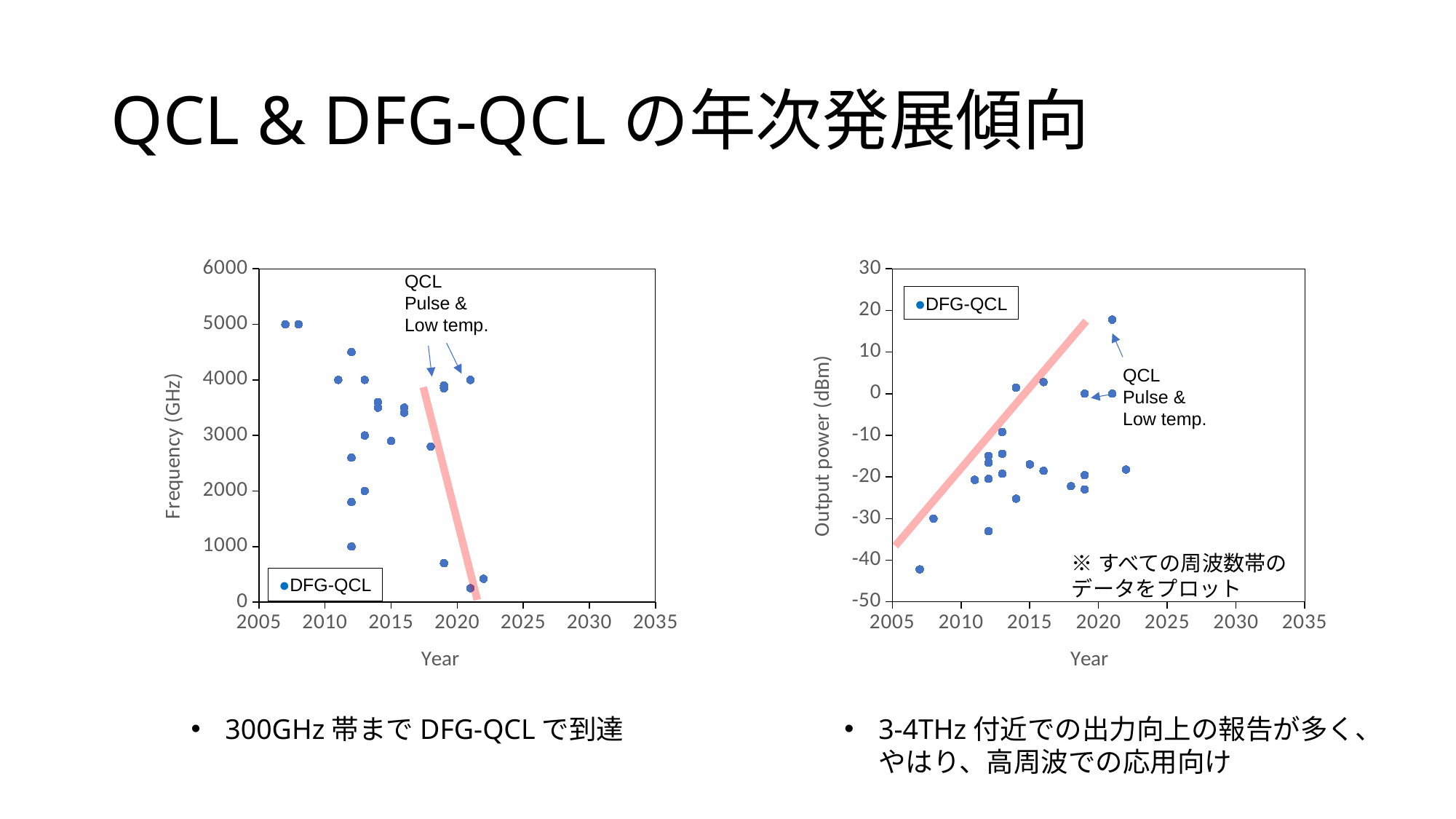
What kind of chart is the right chart (Output power vs Year)? scatter chart In the right chart, is the highest output power value plotted at 2021 greater or less than 10? greater In the right chart, is the output power value plotted at 2007 greater or less than -40? less In the left chart, do the plotted frequency values generally rise or fall as the year increases? fall What is the y-axis label of the left chart? Frequency (GHz) How many series does the legend of the left chart list? 1 In the right chart, do the plotted output power values generally rise or fall as the year increases? rise In the right chart, which year has the highest plotted output power? 2021 In the right chart, which year has the lowest plotted output power? 2007 What series name appears in the legend of the right chart? DFG-QCL What kind of chart is the left chart (Frequency vs Year)? scatter chart